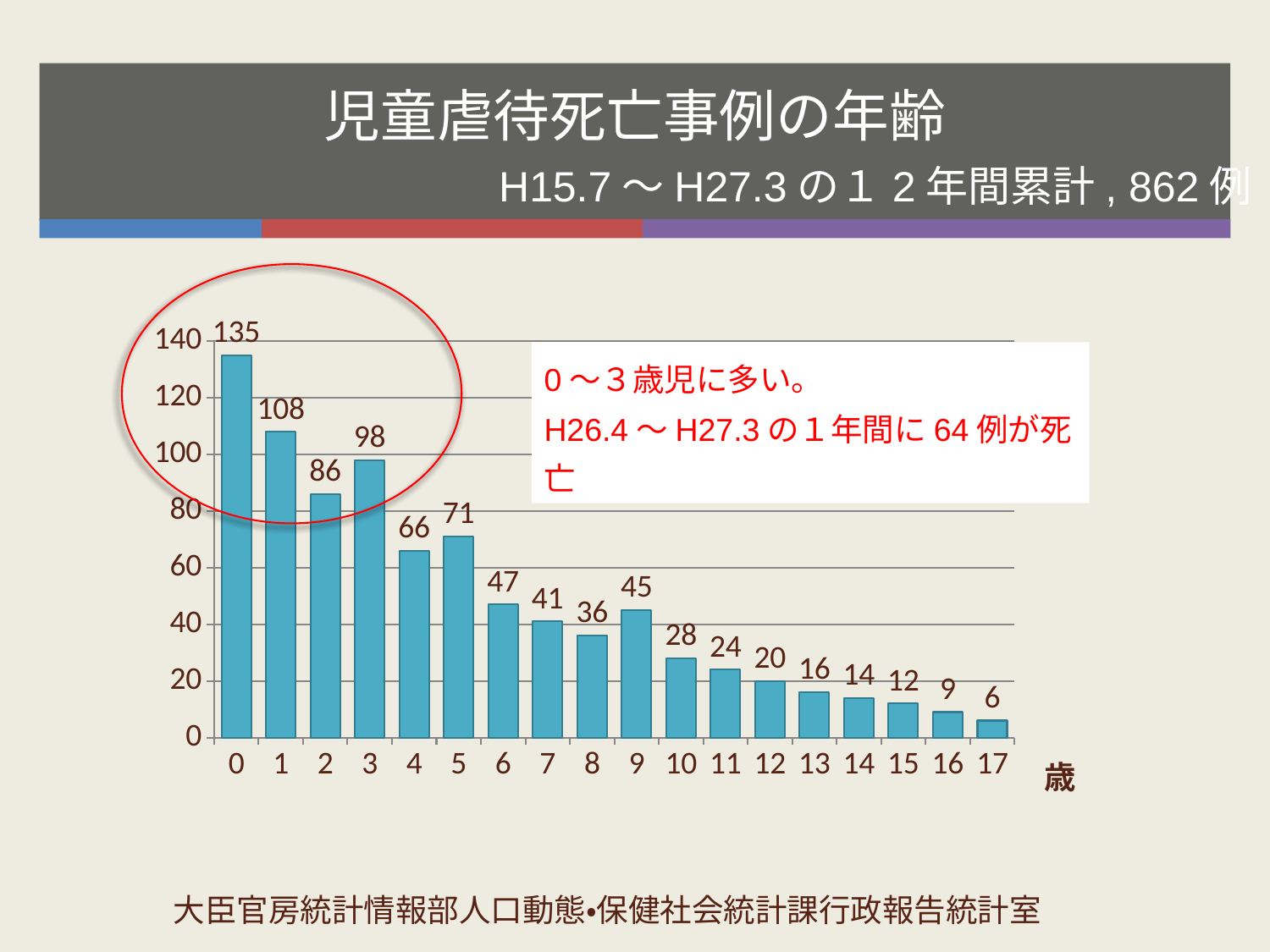
What is the value for age 9? 45 How many age categories are shown on the x axis? 18 Which age has the lowest value? 17 What kind of chart is shown on the slide? bar chart Which is larger, the value for age 2 or the value for age 3? age 3 What is the difference between the values for age 0 and age 1? 27 Is the value for age 5 greater or less than 60? greater What is the value for age 0? 135 What is the unit label shown at the end of the x axis? 歳 What is the value for age 3? 98 What is the value for age 17? 6 Which age has the highest value? 0